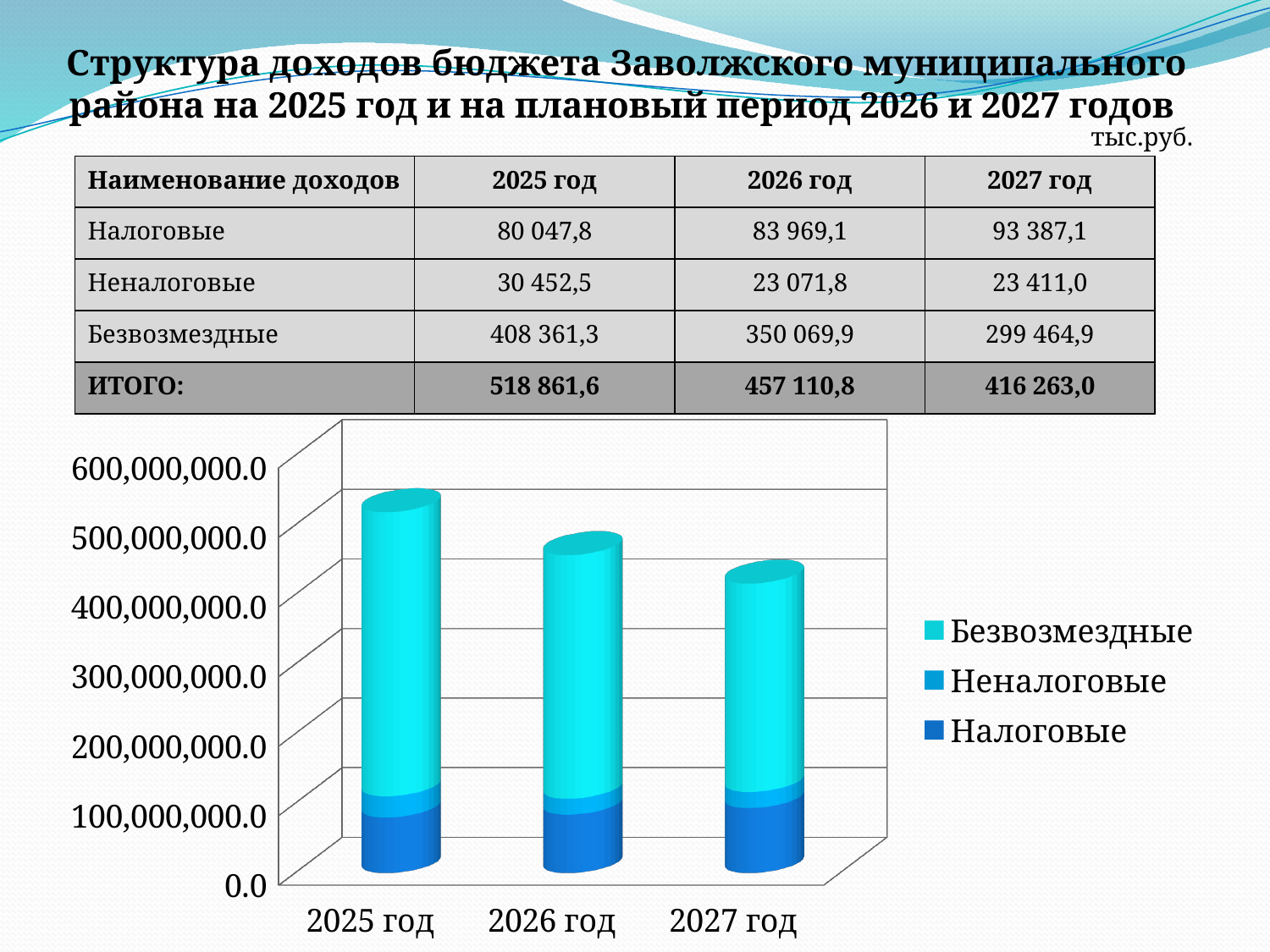
Which year has the tallest stacked bar in the chart? 2025 год What kind of chart is shown on the slide? Stacked bar chart Which series is shown at the bottom of each stacked bar? Налоговые Is the total bar for 2026 год greater or less than 400,000,000.0? greater In the 2025 год bar, which segment is larger: Безвозмездные or Налоговые? Безвозмездные How many years (categories) are plotted on the x axis of the chart? 3 Do the total bar heights rise or fall from 2025 год to 2027 год? Fall What are the three entries in the chart legend? Безвозмездные, Неналоговые, Налоговые Is the total bar for 2025 год greater or less than 400,000,000.0? greater Which year has the shortest stacked bar in the chart? 2027 год Is the total bar for 2027 год greater or less than 500,000,000.0? less How many series does the chart legend list? 3